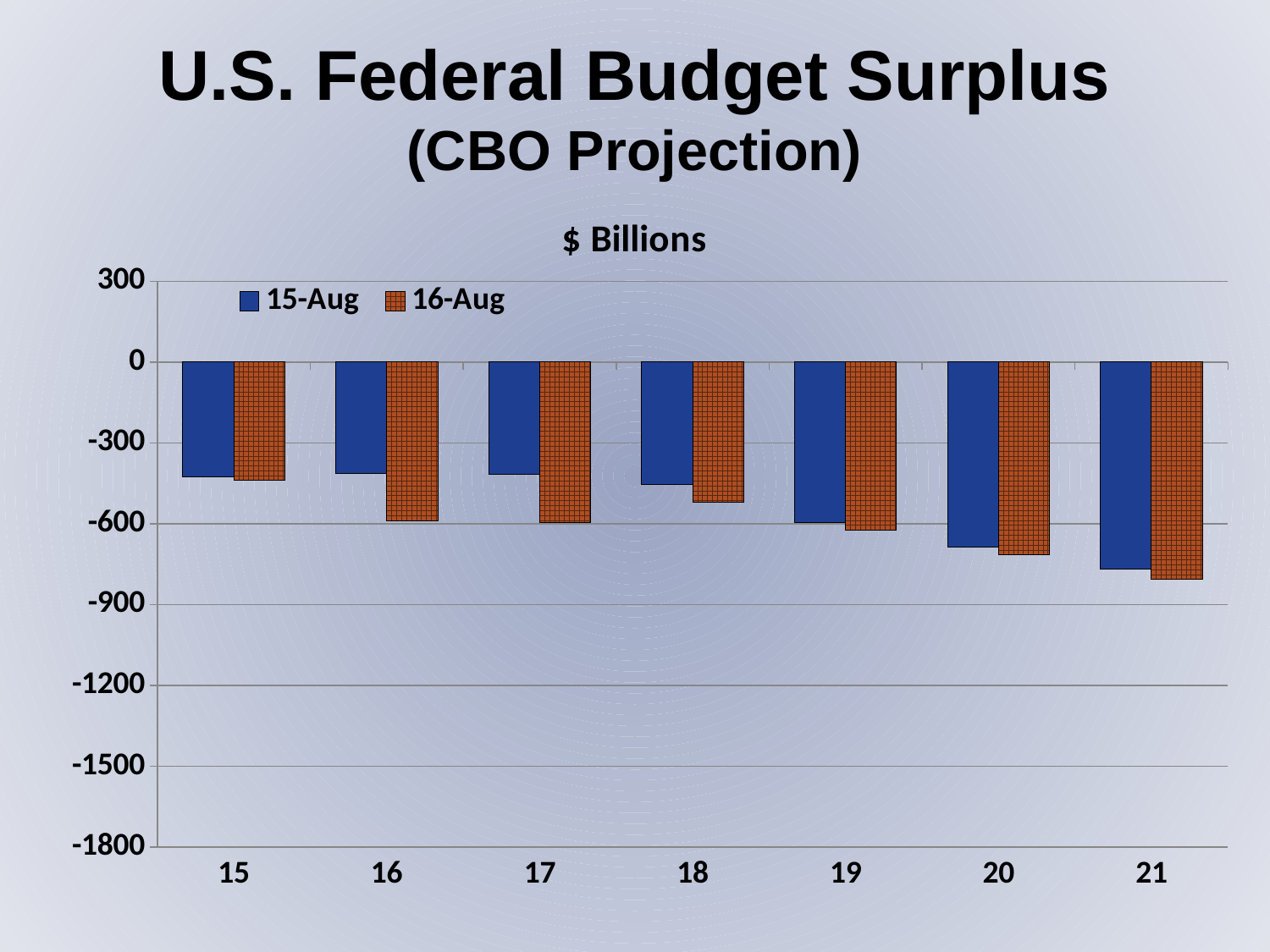
How many years are shown on the x axis? 7 Which year has the lowest (most negative) value for the 16-Aug series? 21 Which year has the highest (least negative) value for the 16-Aug series? 15 For year 16, which series has the larger (less negative) value, 15-Aug or 16-Aug? 15-Aug Is the 15-Aug value for 15 greater or less than -600? greater Is the 16-Aug value for 21 greater or less than -600? less Do the 15-Aug values generally rise or fall from 15 to 21? fall What are the two series named in the legend? 15-Aug and 16-Aug How many series does the legend list? 2 What unit label appears above the chart? $ Billions What kind of chart is shown on the slide? bar chart Which year has the lowest (most negative) value for the 15-Aug series? 21